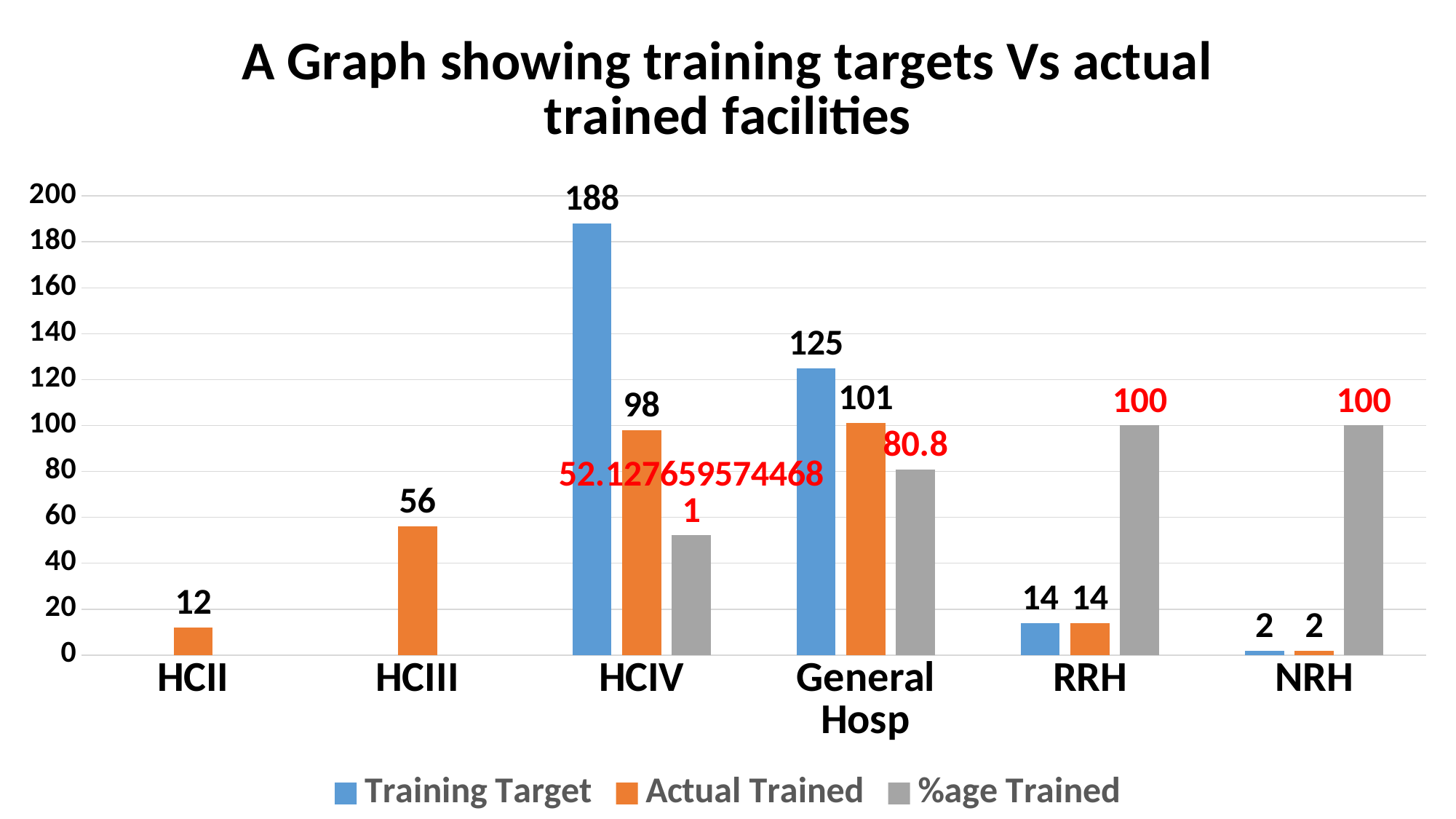
What is the difference between the Training Target and Actual Trained values for HCIV? 90 Which category has the highest Training Target? HCIV How many categories are shown on the x axis? 6 What is the Actual Trained value for General Hosp? 101 Which category has the lowest Actual Trained value? NRH Which has a larger Actual Trained value, HCIV or General Hosp? General Hosp How many series does the legend list? 3 What is the %age Trained value for General Hosp? 80.8 What is the Actual Trained value for HCIII? 56 What kind of chart is shown on the slide? Bar chart What is the Training Target value for HCIV? 188 What is the difference between the Training Target and Actual Trained values for General Hosp? 24